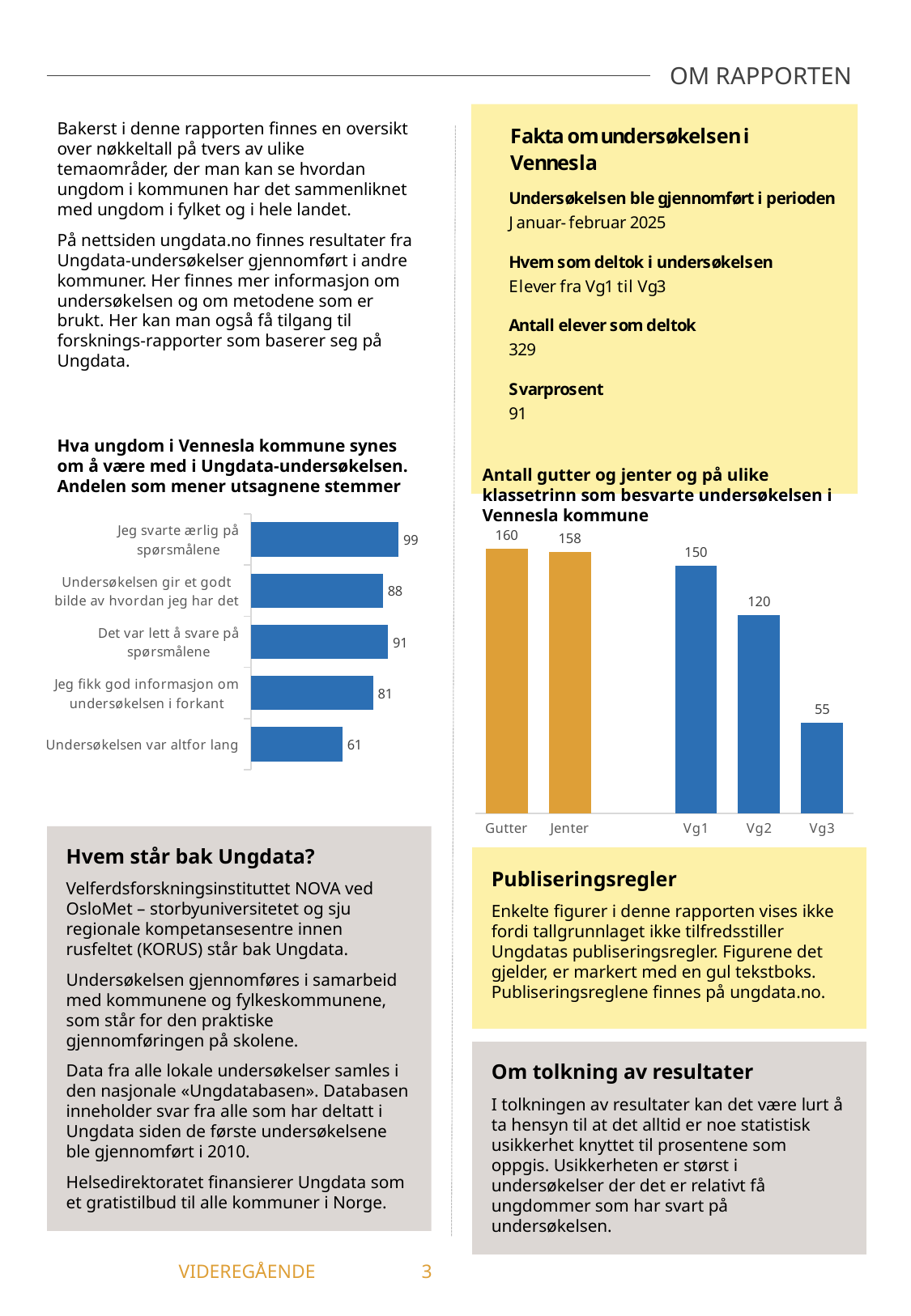
In the chart 'Antall gutter og jenter og på ulike klassetrinn som besvarte undersøkelsen i Vennesla kommune', do the values rise or fall from Vg1 to Vg3? Fall In the chart 'Hva ungdom i Vennesla kommune synes om å være med i Ungdata-undersøkelsen', what is the value for 'Undersøkelsen var altfor lang'? 61 In the chart 'Antall gutter og jenter og på ulike klassetrinn som besvarte undersøkelsen i Vennesla kommune', which class level has the highest value? Vg1 In the chart 'Hva ungdom i Vennesla kommune synes om å være med i Ungdata-undersøkelsen', what is the value for 'Jeg svarte ærlig på spørsmålene'? 99 In the chart 'Antall gutter og jenter og på ulike klassetrinn som besvarte undersøkelsen i Vennesla kommune', what is the value for Vg3? 55 In the chart 'Hva ungdom i Vennesla kommune synes om å være med i Ungdata-undersøkelsen', what is the difference between 'Det var lett å svare på spørsmålene' and 'Jeg fikk god informasjon om undersøkelsen i forkant'? 10 In the chart 'Antall gutter og jenter og på ulike klassetrinn som besvarte undersøkelsen i Vennesla kommune', what is the difference between Vg2 and Vg3? 65 In the chart 'Antall gutter og jenter og på ulike klassetrinn som besvarte undersøkelsen i Vennesla kommune', what colour are the bars for Gutter and Jenter? Orange In the chart 'Antall gutter og jenter og på ulike klassetrinn som besvarte undersøkelsen i Vennesla kommune', what is the value for Gutter? 160 In the chart 'Hva ungdom i Vennesla kommune synes om å være med i Ungdata-undersøkelsen', how many statements are shown? 5 What kind of chart is 'Hva ungdom i Vennesla kommune synes om å være med i Ungdata-undersøkelsen'? Bar chart In the chart 'Hva ungdom i Vennesla kommune synes om å være med i Ungdata-undersøkelsen', which statement has the lowest value? Undersøkelsen var altfor lang